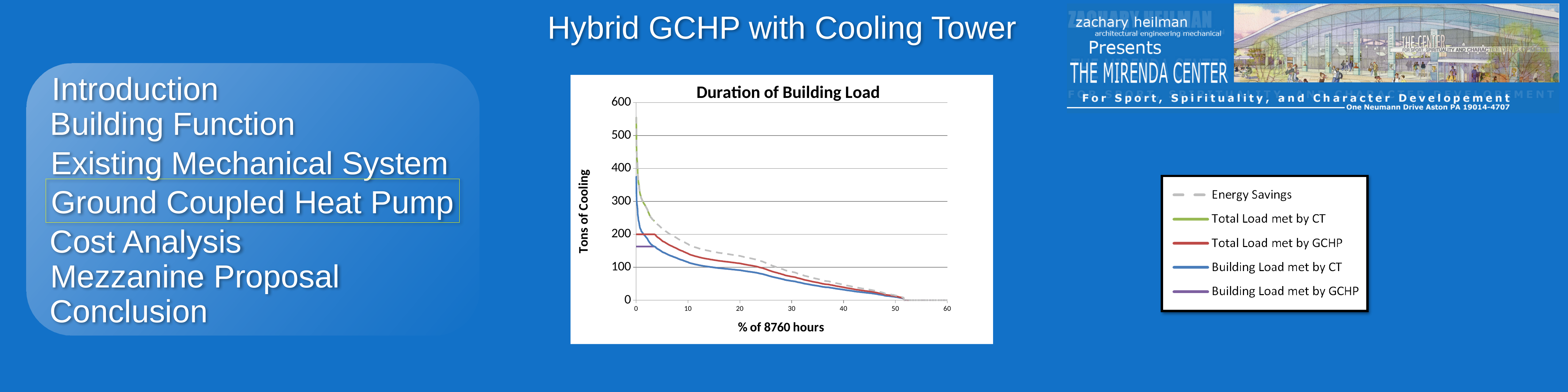
At 20% of 8760 hours, which is larger: Energy Savings or Building Load met by CT? Energy Savings What is the label of the y axis of the chart? Tons of Cooling At 0% of 8760 hours, which is larger: Total Load met by CT or Total Load met by GCHP? Total Load met by CT Is the value of Building Load met by GCHP at 0% of 8760 hours greater or less than 200? less Do the values of the Building Load met by CT series rise or fall as the x axis increases? fall Is the value of Building Load met by GCHP at 0% of 8760 hours greater or less than 100? greater Do the values of the Energy Savings series rise or fall as the x axis increases? fall What is the title of the chart? Duration of Building Load How many series does the legend list for the chart? 5 Is the value of Building Load met by CT at 30% of 8760 hours greater or less than 100? less What kind of chart is shown on the slide? line chart